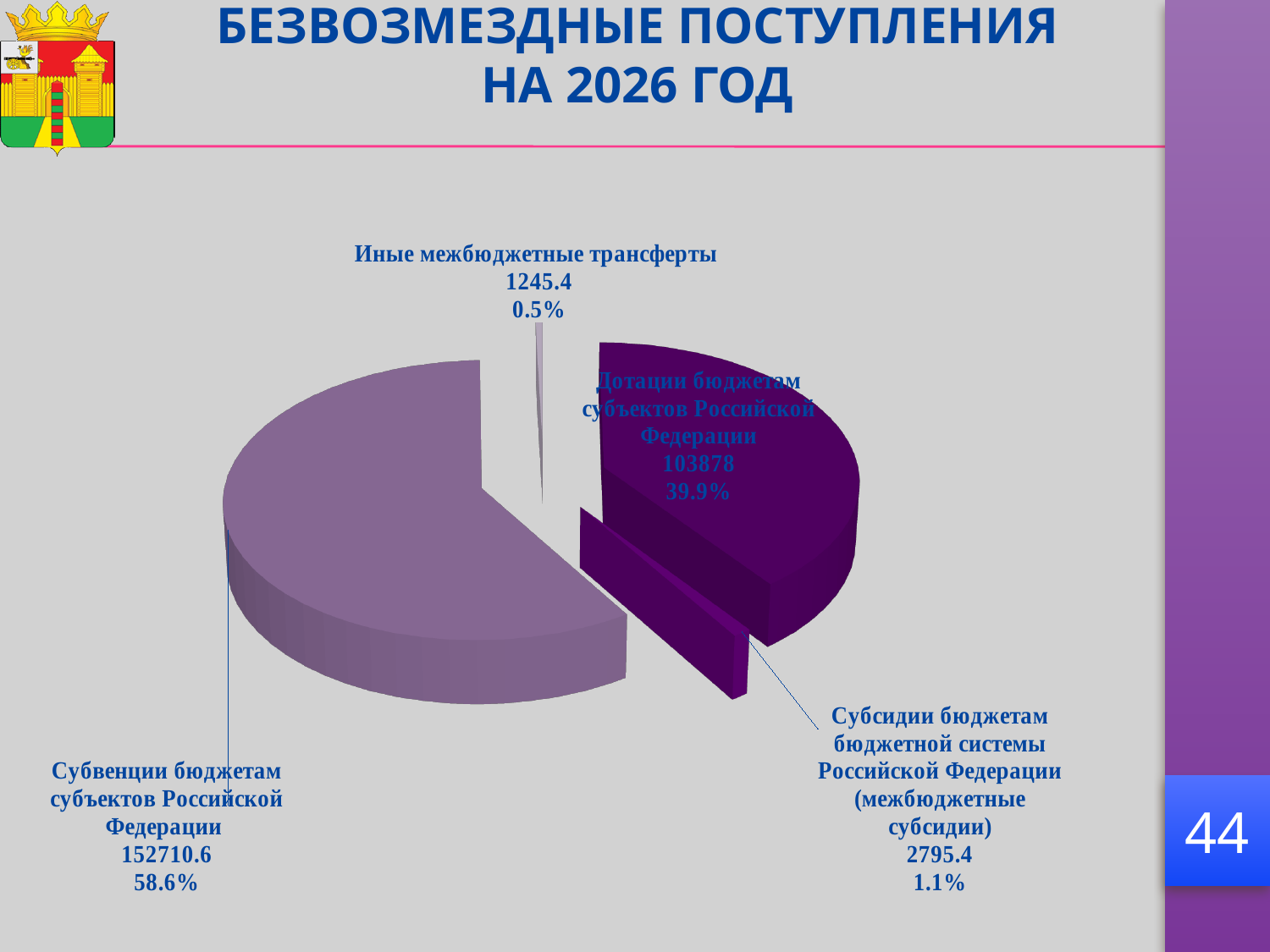
Which category has the largest slice of the pie? Субвенции бюджетам субъектов Российской Федерации What is the value shown for Дотации бюджетам субъектов Российской Федерации? 103878 What type of chart is shown on the slide? Pie chart What is the value shown for Субсидии бюджетам бюджетной системы Российской Федерации (межбюджетные субсидии)? 2795.4 What is the value shown for Иные межбюджетные трансферты? 1245.4 Which is larger: Субсидии бюджетам бюджетной системы Российской Федерации (межбюджетные субсидии) or Иные межбюджетные трансферты? Субсидии бюджетам бюджетной системы Российской Федерации (межбюджетные субсидии) What share of the pie does Субвенции бюджетам субъектов Российской Федерации represent? 58.6% How many slices does the pie chart have? 4 Which category has the smallest slice of the pie? Иные межбюджетные трансферты What share of the pie does Дотации бюджетам субъектов Российской Федерации represent? 39.9% What share of the pie does Иные межбюджетные трансферты represent? 0.5% What is the value shown for Субвенции бюджетам субъектов Российской Федерации? 152710.6